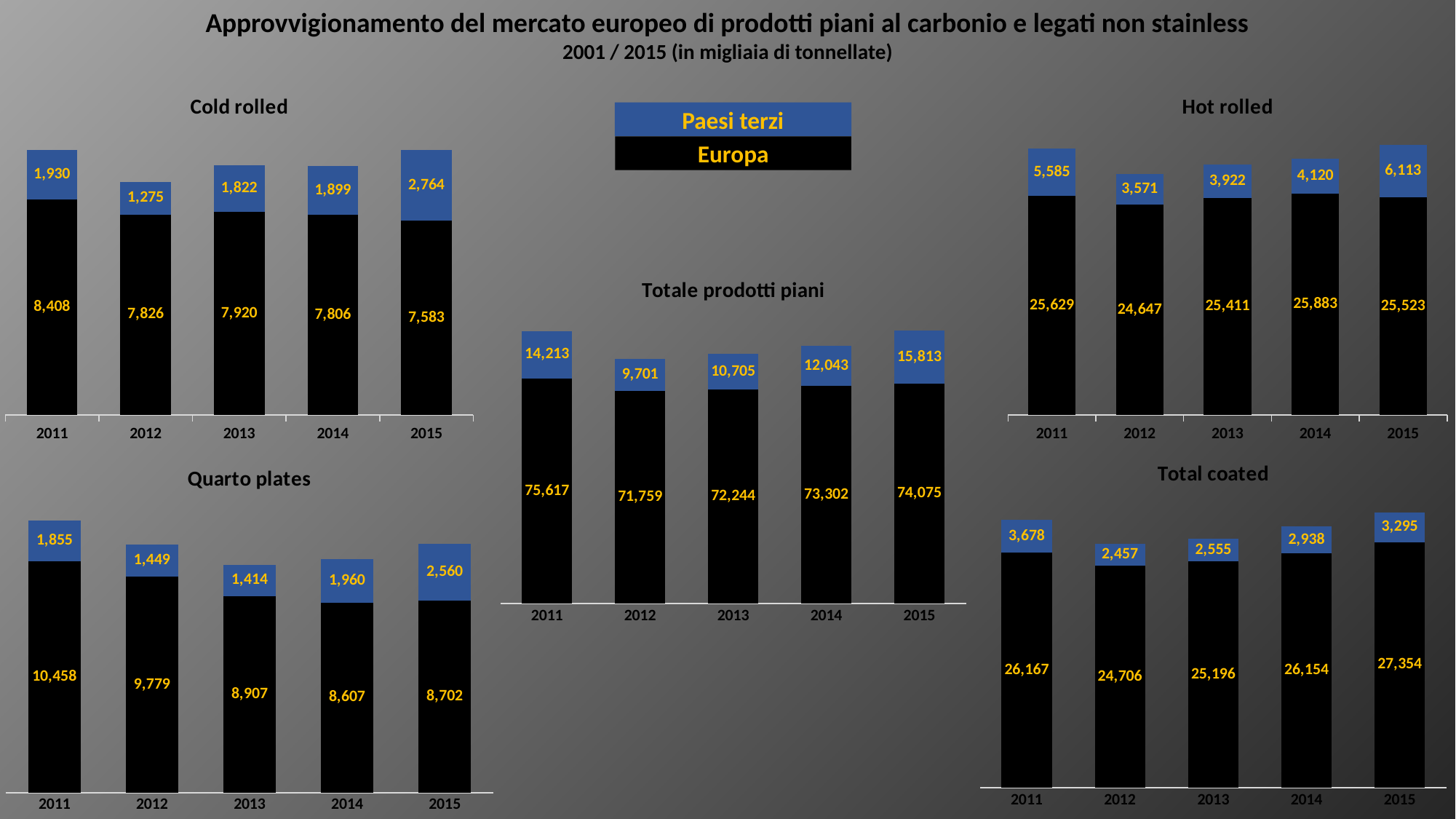
In the Totale prodotti piani chart, what is the total of the stacked bar for 2015? 89,888 What kind of chart is the Hot rolled chart? stacked bar chart In the Total coated chart, what is the difference between the Europa values for 2015 and 2012? 2,648 In the Cold rolled chart, what is the Paesi terzi value for 2015? 2,764 How many series does the legend list? 2 In the Hot rolled chart, what is the difference between the Paesi terzi values for 2015 and 2011? 528 In the Quarto plates chart, how many years are shown on the x axis? 5 In the Quarto plates chart, which year has the highest Europa value? 2011 In the Totale prodotti piani chart, what is the Paesi terzi value for 2012? 9,701 In the Cold rolled chart, is the Europa value for 2011 larger or smaller than the Europa value for 2015? larger In the Total coated chart, which year has the lowest Paesi terzi value? 2012 In the Hot rolled chart, what is the Europa value for 2014? 25,883